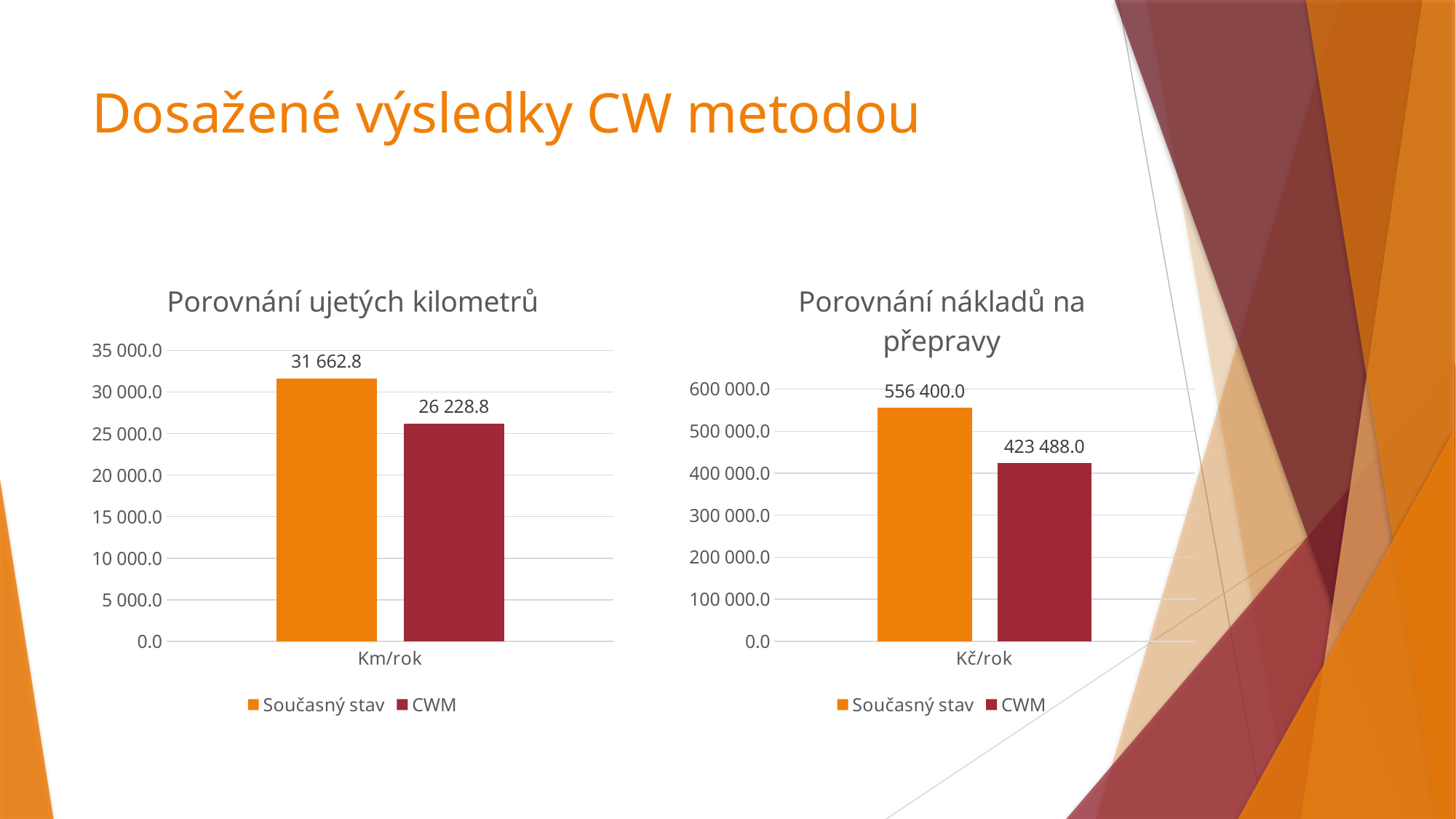
What is the category label on the x axis of the chart 'Porovnání nákladů na přepravy'? Kč/rok In the chart 'Porovnání ujetých kilometrů', what is the value for CWM? 26 228.8 What kind of chart is 'Porovnání nákladů na přepravy'? bar chart In the chart 'Porovnání nákladů na přepravy', which series has the lower value? CWM In the chart 'Porovnání nákladů na přepravy', what is the value for CWM? 423 488.0 In the chart 'Porovnání nákladů na přepravy', is the value for CWM greater or less than 500 000.0? less In the chart 'Porovnání nákladů na přepravy', what is the difference between the Současný stav and CWM values? 132 912.0 In the chart 'Porovnání ujetých kilometrů', which series has the higher value? Současný stav How many series does the legend of the chart 'Porovnání ujetých kilometrů' list? 2 In the chart 'Porovnání ujetých kilometrů', what is the difference between the Současný stav and CWM values? 5 434.0 In the chart 'Porovnání nákladů na přepravy', what is the value for Současný stav? 556 400.0 In the chart 'Porovnání ujetých kilometrů', what is the value for Současný stav? 31 662.8